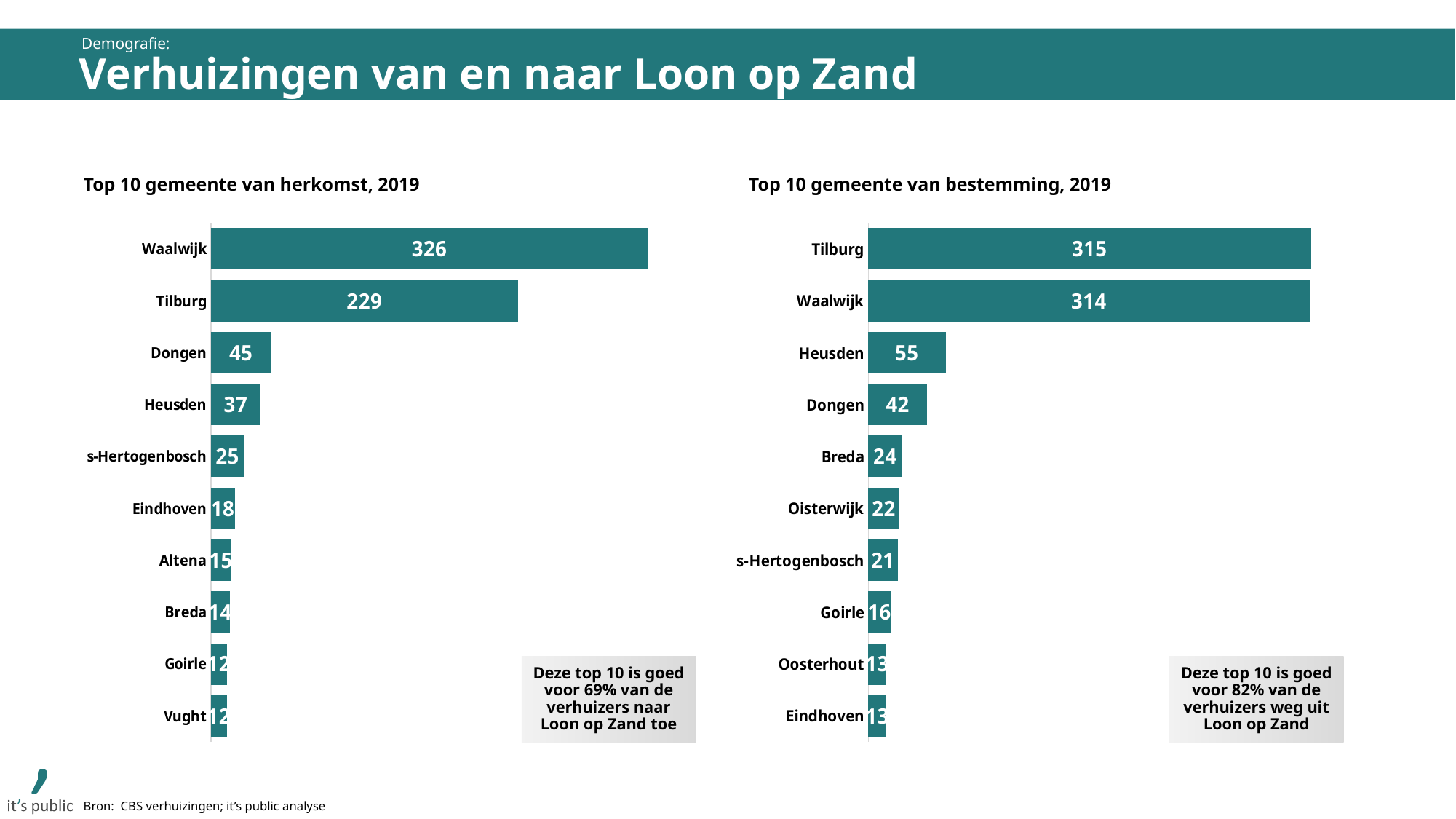
In the 'Top 10 gemeente van bestemming, 2019' chart, which municipality has the lowest value? Oosterhout and Eindhoven (both 13) In the 'Top 10 gemeente van herkomst, 2019' chart, which municipality has the highest value? Waalwijk How many municipalities are shown in the 'Top 10 gemeente van bestemming, 2019' chart? 10 In the 'Top 10 gemeente van bestemming, 2019' chart, what is the value for Heusden? 55 In the 'Top 10 gemeente van herkomst, 2019' chart, what is the difference between Waalwijk and Tilburg? 97 In the 'Top 10 gemeente van bestemming, 2019' chart, what is the value for Oisterwijk? 22 What kind of chart is the 'Top 10 gemeente van herkomst, 2019' chart? Bar chart In the 'Top 10 gemeente van herkomst, 2019' chart, what is the value for s-Hertogenbosch? 25 In the 'Top 10 gemeente van herkomst, 2019' chart, which is larger: Dongen or Heusden? Dongen In the 'Top 10 gemeente van bestemming, 2019' chart, what is the difference between Tilburg and Waalwijk? 1 In the 'Top 10 gemeente van herkomst, 2019' chart, what is the value for Waalwijk? 326 According to the text box on the 'Top 10 gemeente van bestemming, 2019' chart, what share of movers leaving Loon op Zand does the top 10 account for? 82%